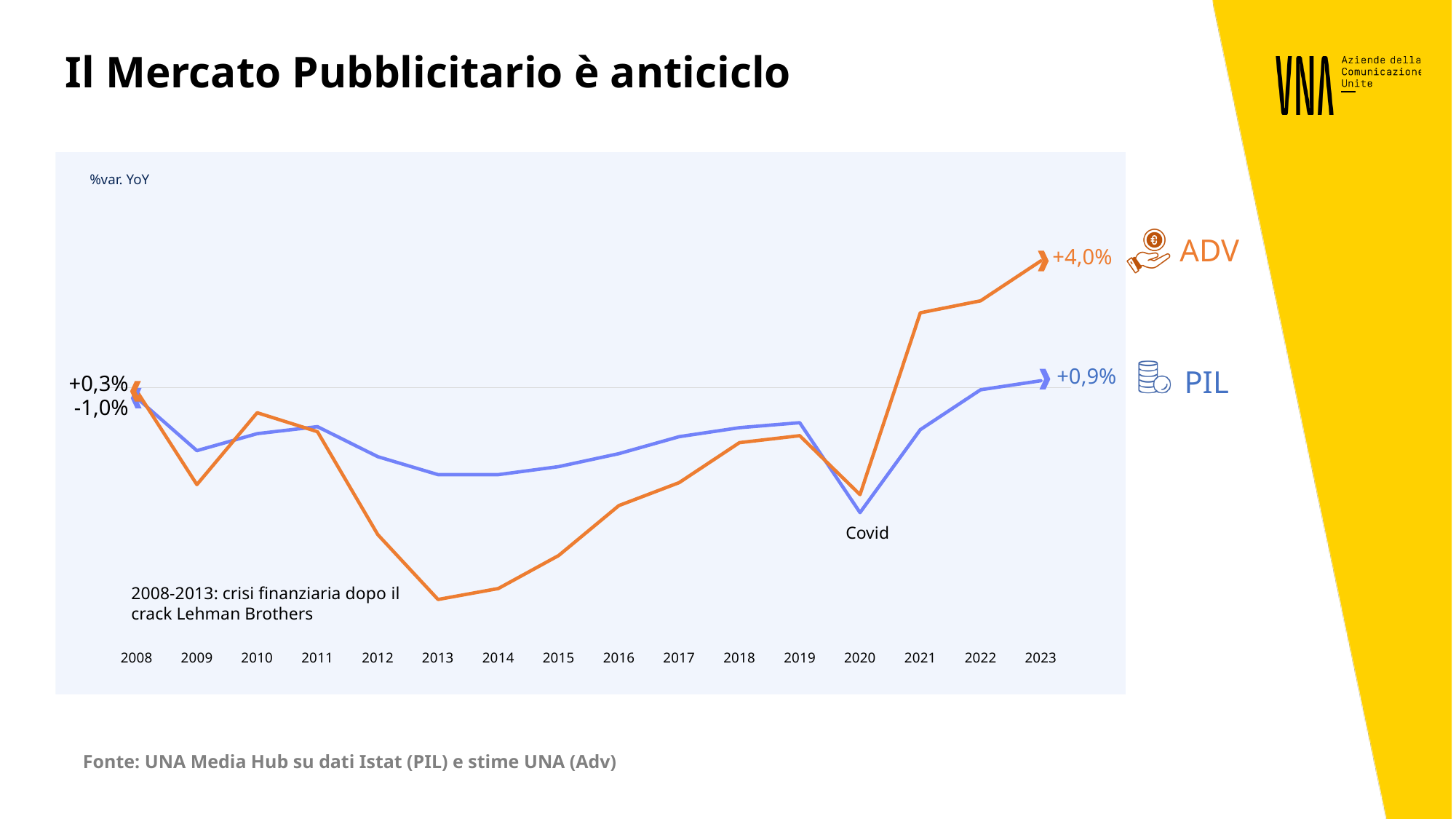
How many years are shown on the x axis of the chart? 16 What is the value for PIL in 2023? +0,9% How many series does the chart show? 2 What is the value for PIL in 2008? -1,0% In which year does the ADV line reach its lowest point? 2013 What is the value for ADV in 2008? +0,3% What is the value for ADV in 2023? +4,0% What type of chart is shown on the slide? Line chart In 2023, which series has the higher value, ADV or PIL? ADV Which year on the chart is annotated with the label 'Covid'? 2020 What is the difference between the ADV and PIL values in 2023? 3,1 percentage points In which year does the PIL line reach its lowest point? 2020